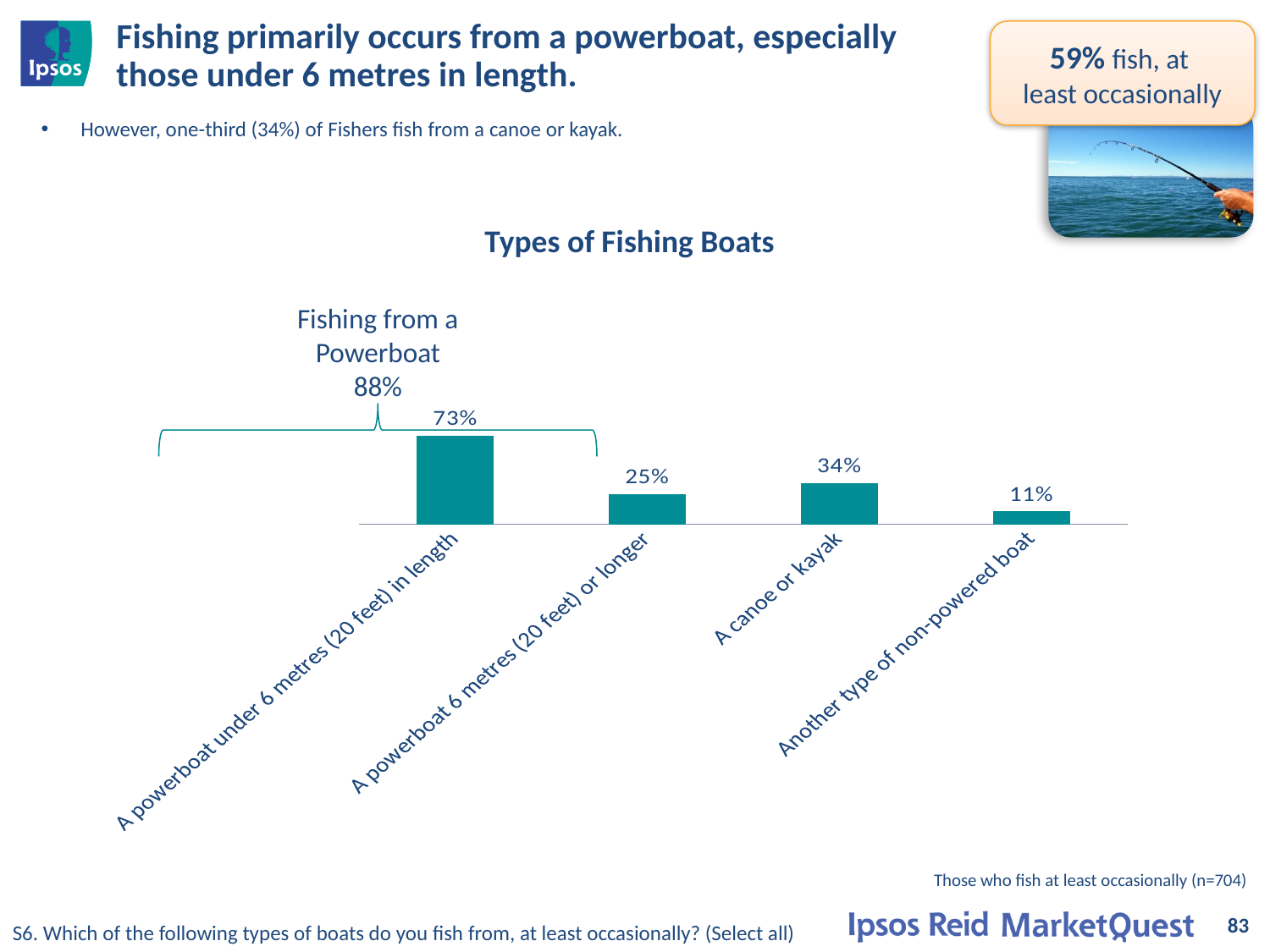
How many categories are shown in the chart? 4 What is the value for 'A powerboat under 6 metres (20 feet) in length'? 73% Which type of boat has the highest value? A powerboat under 6 metres (20 feet) in length What kind of chart is shown on the slide? Bar chart What is the difference between the values for 'A powerboat under 6 metres (20 feet) in length' and 'A canoe or kayak'? 39% Which type of boat has the lowest value? Another type of non-powered boat What is the value for 'A canoe or kayak'? 34% Which is larger: the value for 'A canoe or kayak' or for 'A powerboat 6 metres (20 feet) or longer'? A canoe or kayak What combined value is shown for 'Fishing from a Powerboat' above the bracket? 88% What is the value for 'A powerboat 6 metres (20 feet) or longer'? 25% What is the title of the chart? Types of Fishing Boats What is the value for 'Another type of non-powered boat'? 11%